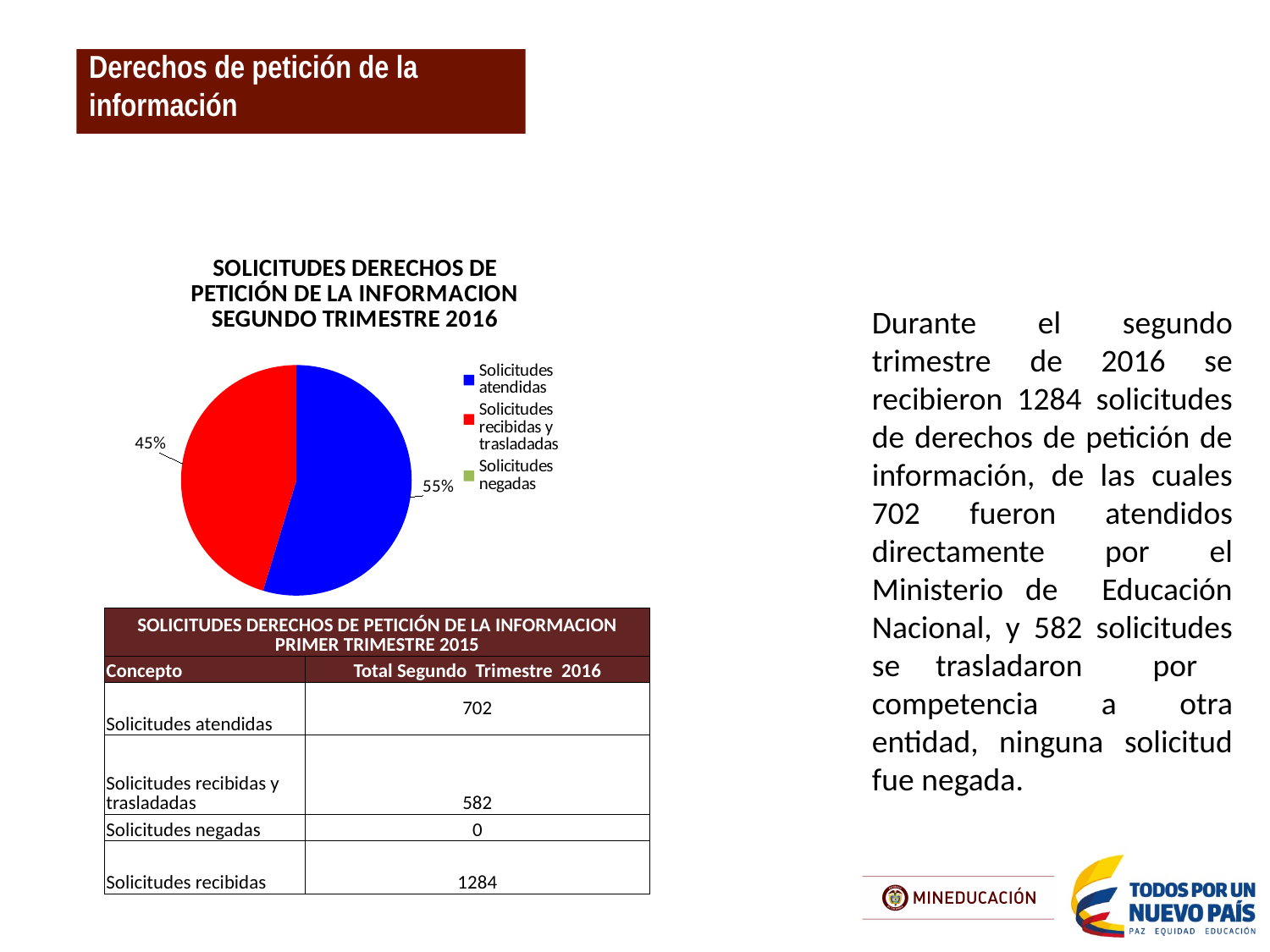
Which colour represents "Solicitudes recibidas y trasladadas" in the pie chart? red Which category has the largest slice of the pie? Solicitudes atendidas What share of the pie does "Solicitudes recibidas y trasladadas" represent? 45% What kind of chart is shown on the slide? pie chart What is the difference in percentage points between the "Solicitudes atendidas" slice and the "Solicitudes recibidas y trasladadas" slice? 10 percentage points Is the share for "Solicitudes atendidas" greater or less than 50%? greater Which legend entry has no visible slice in the pie chart? Solicitudes negadas Which of the two labelled slices is larger: "Solicitudes atendidas" or "Solicitudes recibidas y trasladadas"? Solicitudes atendidas How many entries does the legend of the pie chart list? 3 What is the title of the pie chart? SOLICITUDES DERECHOS DE PETICIÓN DE LA INFORMACION SEGUNDO TRIMESTRE 2016 What share of the pie does "Solicitudes atendidas" represent? 55%